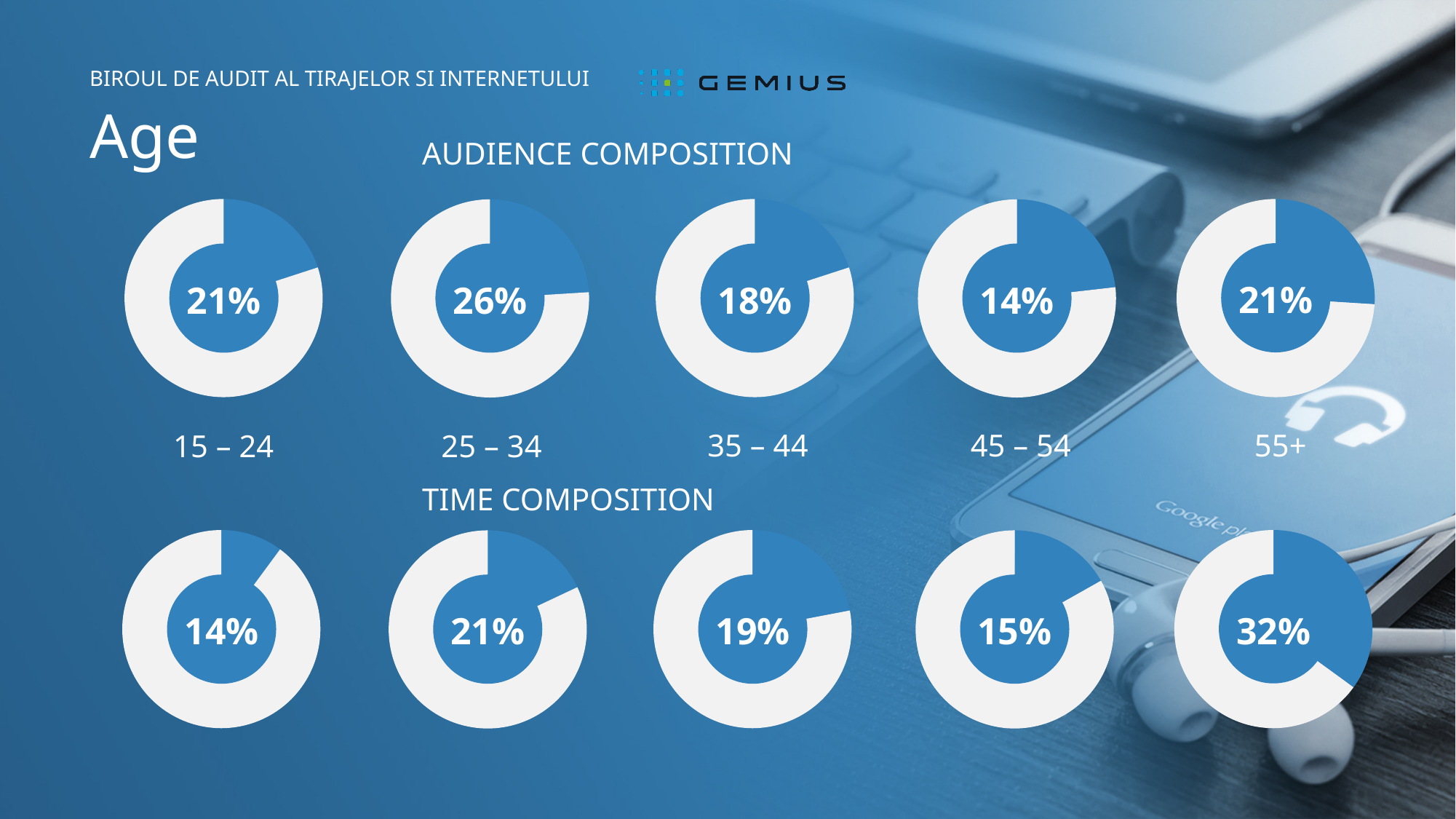
How many age groups are shown in the Audience Composition row? 5 In the Audience Composition row, which age group has the highest share? 25 – 34 In the Time Composition row, what share is shown for the 15 – 24 age group? 14% What is the difference between the Audience Composition shares for the 25 – 34 and 45 – 54 age groups? 12% In the Time Composition row, which age group has the highest share? 55+ In the Time Composition row, which age group has the lowest share? 15 – 24 In the Audience Composition row, what share is shown for the 45 – 54 age group? 14% What is the difference between the Audience Composition share and the Time Composition share for the 55+ age group? 11% In the Time Composition row, what share is shown for the 55+ age group? 32% For the 35 – 44 age group, which is larger: the Audience Composition share or the Time Composition share? Time Composition What kind of chart is used to show each age group's share on the slide? Donut chart In the Audience Composition row, what share is shown for the 25 – 34 age group? 26%